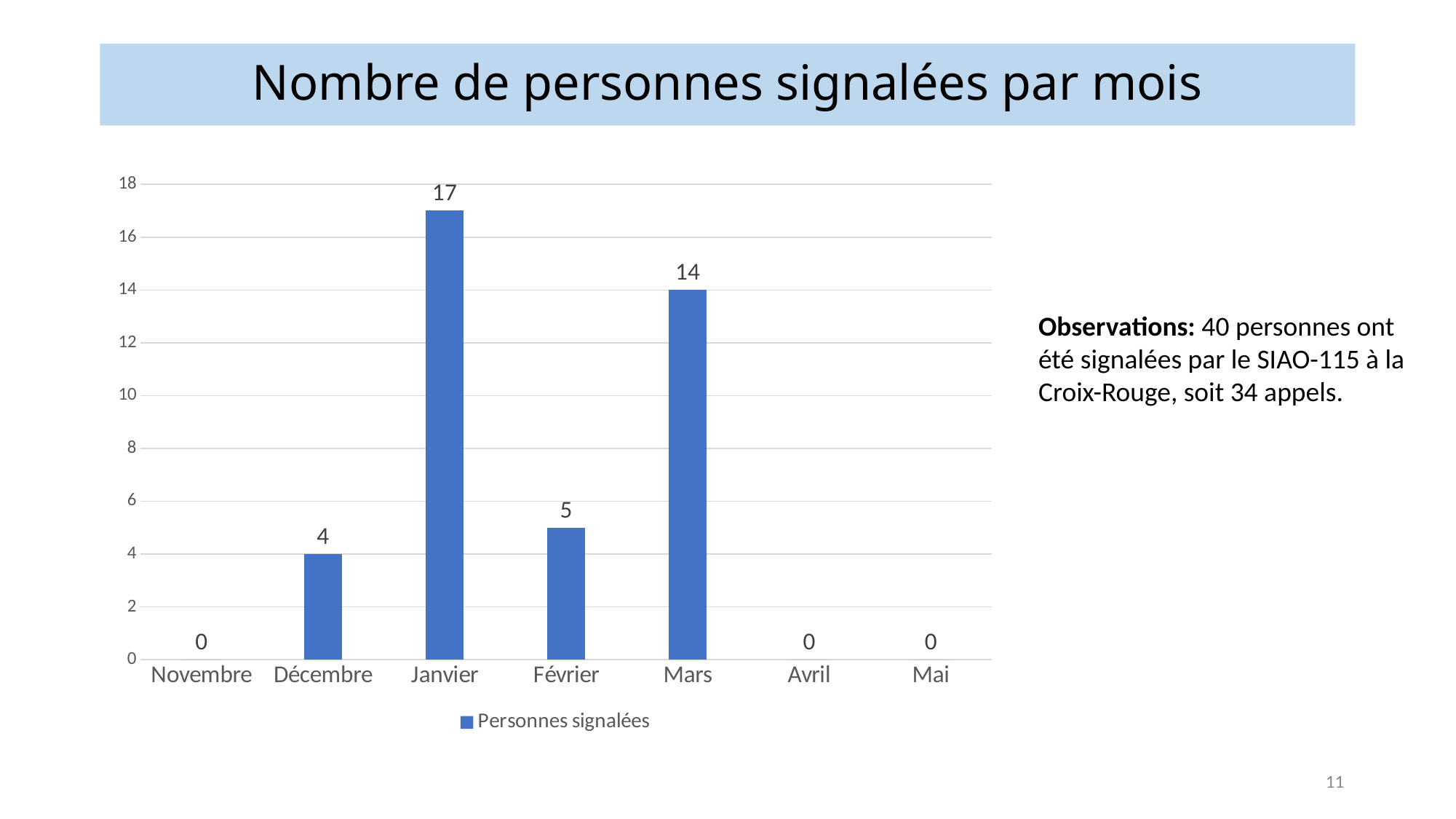
What is the value for Février? 5 Which is larger, the value for Décembre or the value for Février? Février Is the value for Mars greater or less than 10? greater What is the value for Mars? 14 What is the value for Janvier? 17 What is the difference between the values for Janvier and Mars? 3 Which month has the highest value? Janvier What is the legend entry for the series? Personnes signalées How many months are shown on the x axis? 7 What is the value for Décembre? 4 What kind of chart is shown? bar chart How many series does the legend list? 1